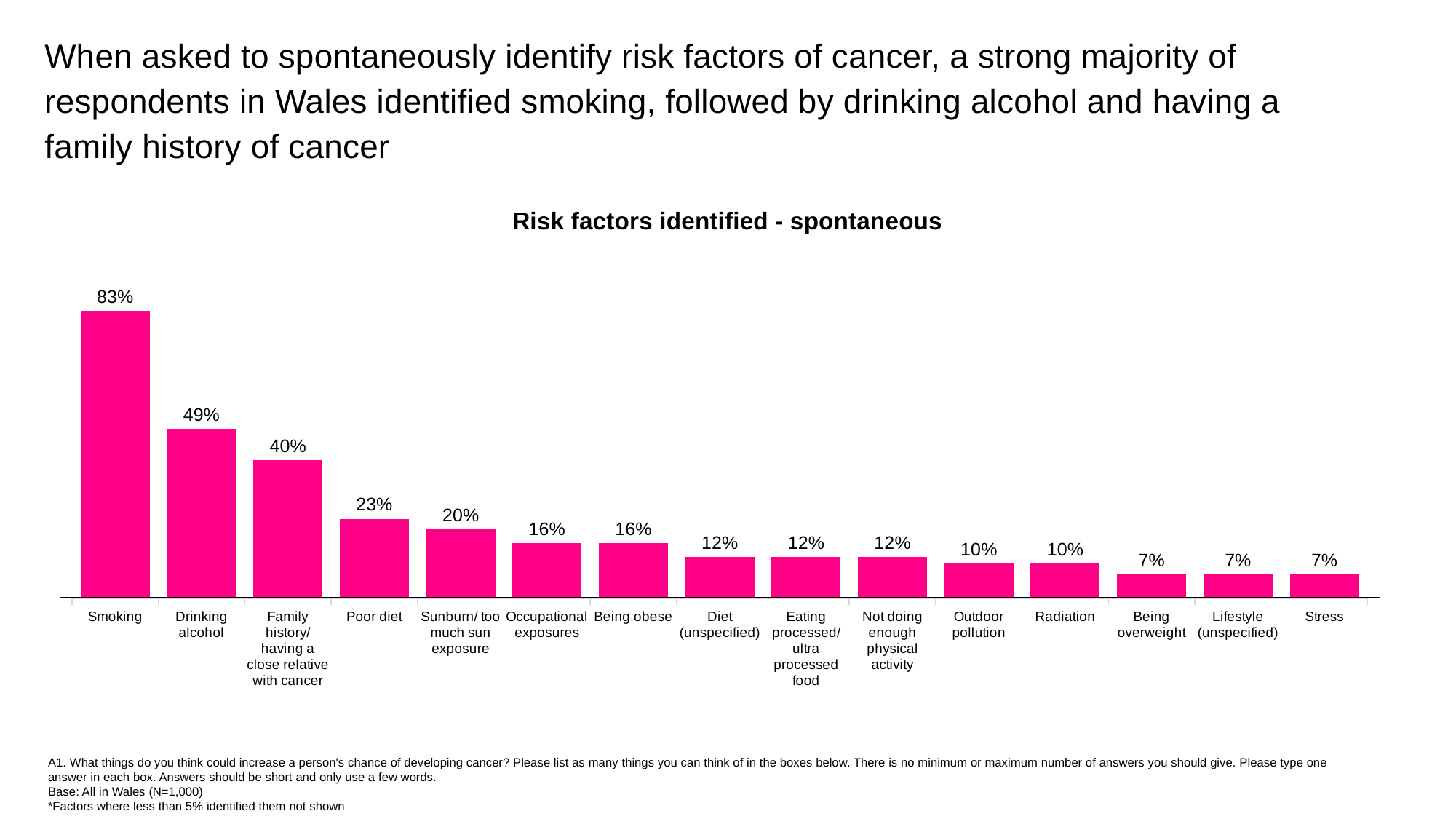
What percentage identified Poor diet? 23% Which risk factor has the highest value? Smoking What is the value for Radiation? 10% Which is larger, the value for Sunburn/ too much sun exposure or the value for Outdoor pollution? Sunburn/ too much sun exposure What is the value for Drinking alcohol? 49% What is the difference between the values for Smoking and Drinking alcohol? 34% What is the title of the chart? Risk factors identified - spontaneous How many risk factor categories are shown in the chart? 15 What percentage of respondents identified smoking as a risk factor? 83% Do the values rise or fall moving from left to right along the x axis? Fall What kind of chart is shown on the slide? Bar chart What is the difference between the values for Family history/ having a close relative with cancer and Poor diet? 17%